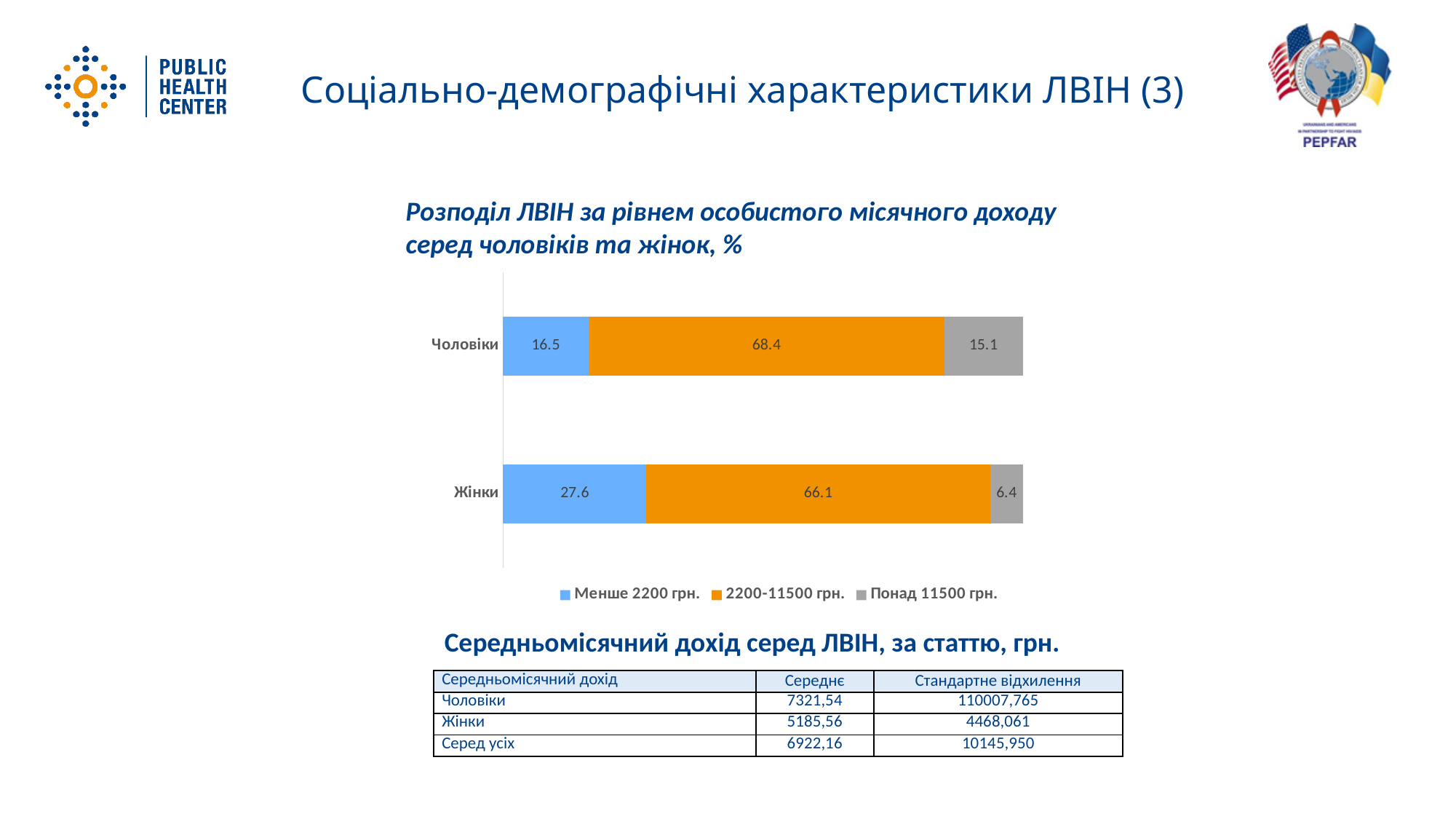
What is the value for Жінки in the 2200-11500 грн. series? 66.1 What is the value for Жінки in the Понад 11500 грн. series? 6.4 What is the difference between the Понад 11500 грн. values for Чоловіки and Жінки? 8.7 Which category has the lower value in the Понад 11500 грн. series? Жінки What is the difference between the Менше 2200 грн. values for Жінки and Чоловіки? 11.1 How many series does the legend list? 3 What is the total of the stacked bar for Чоловіки? 100 Which category has the higher value in the Менше 2200 грн. series, Чоловіки or Жінки? Жінки What is the value for Чоловіки in the Понад 11500 грн. series? 15.1 What is the value for Чоловіки in the Менше 2200 грн. series? 16.5 What kind of chart is shown on the slide? Stacked bar chart How many categories are shown on the chart? 2